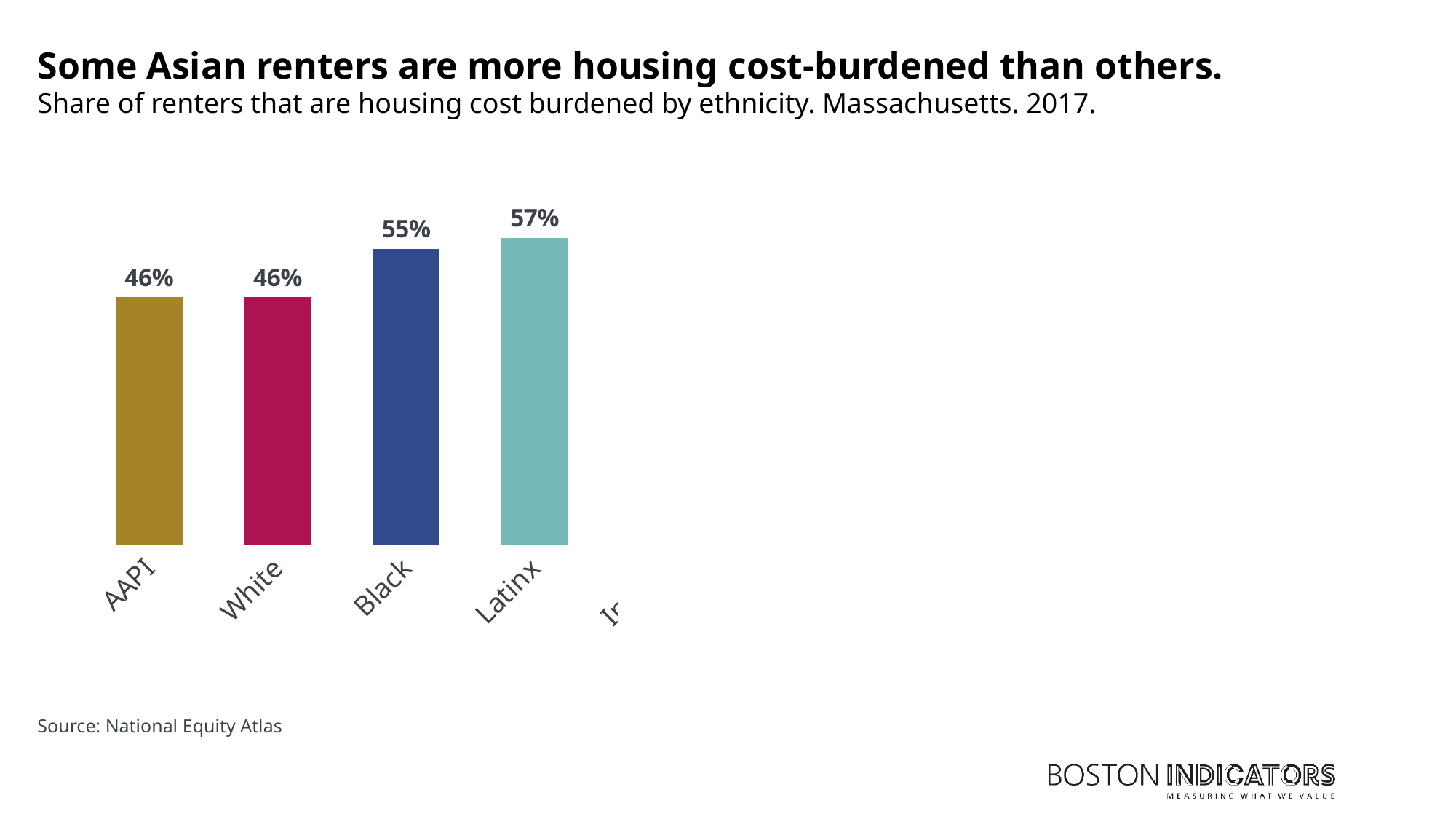
Which ethnicity has the highest share of housing cost-burdened renters? Latinx What is the share of AAPI renters that are housing cost burdened? 46% What kind of chart is shown on the slide? Bar chart What is the share of Black renters that are housing cost burdened? 55% What is the source cited for the chart? National Equity Atlas What is the difference in percentage points between the Black and White shares? 9 percentage points What is the share of Latinx renters that are housing cost burdened? 57% What is the share of White renters that are housing cost burdened? 46% Which is larger, the share for Black renters or the share for White renters? Black How many bars are plotted on the chart? 4 What is the difference in percentage points between the Latinx and AAPI shares? 11 percentage points Which two ethnicities share the lowest value on the chart? AAPI and White